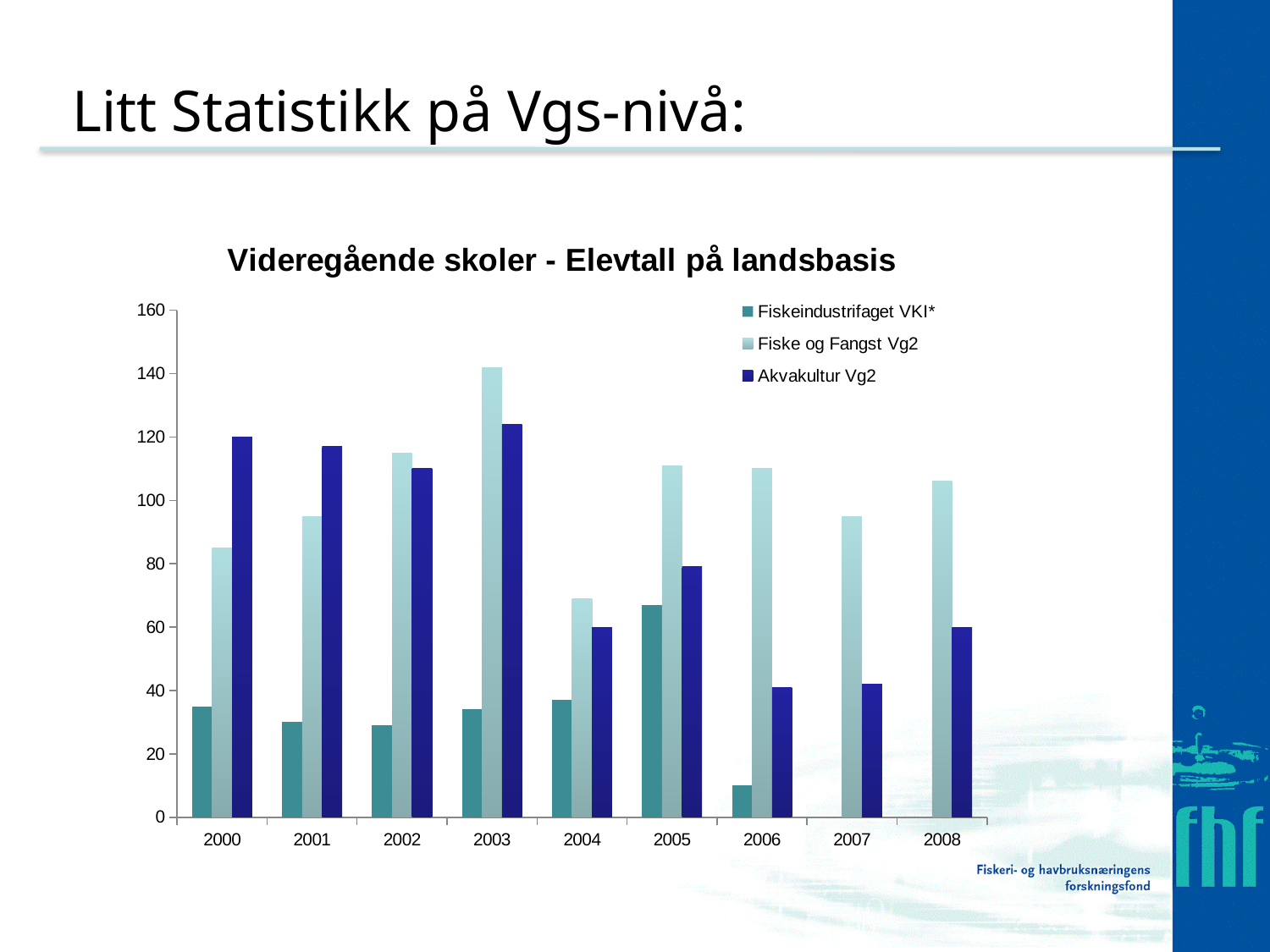
In which year is the value for Fiskeindustrifaget VKI* highest? 2005 In 2008, which series has the larger value: Fiske og Fangst Vg2 or Akvakultur Vg2? Fiske og Fangst Vg2 Is the value for Fiskeindustrifaget VKI* in 2006 greater or less than 20? less How many years are shown on the x axis? 9 In which year is the value for Fiske og Fangst Vg2 highest? 2003 Is the value for Fiske og Fangst Vg2 in 2003 greater or less than 120? greater How many series does the legend list? 3 In which year is the value for Fiske og Fangst Vg2 lowest? 2004 What is the title of the chart? Videregående skoler - Elevtall på landsbasis In 2000, which series has the larger value: Akvakultur Vg2 or Fiske og Fangst Vg2? Akvakultur Vg2 What kind of chart is shown on the slide? Bar chart Is the value for Akvakultur Vg2 in 2004 greater or less than 80? less